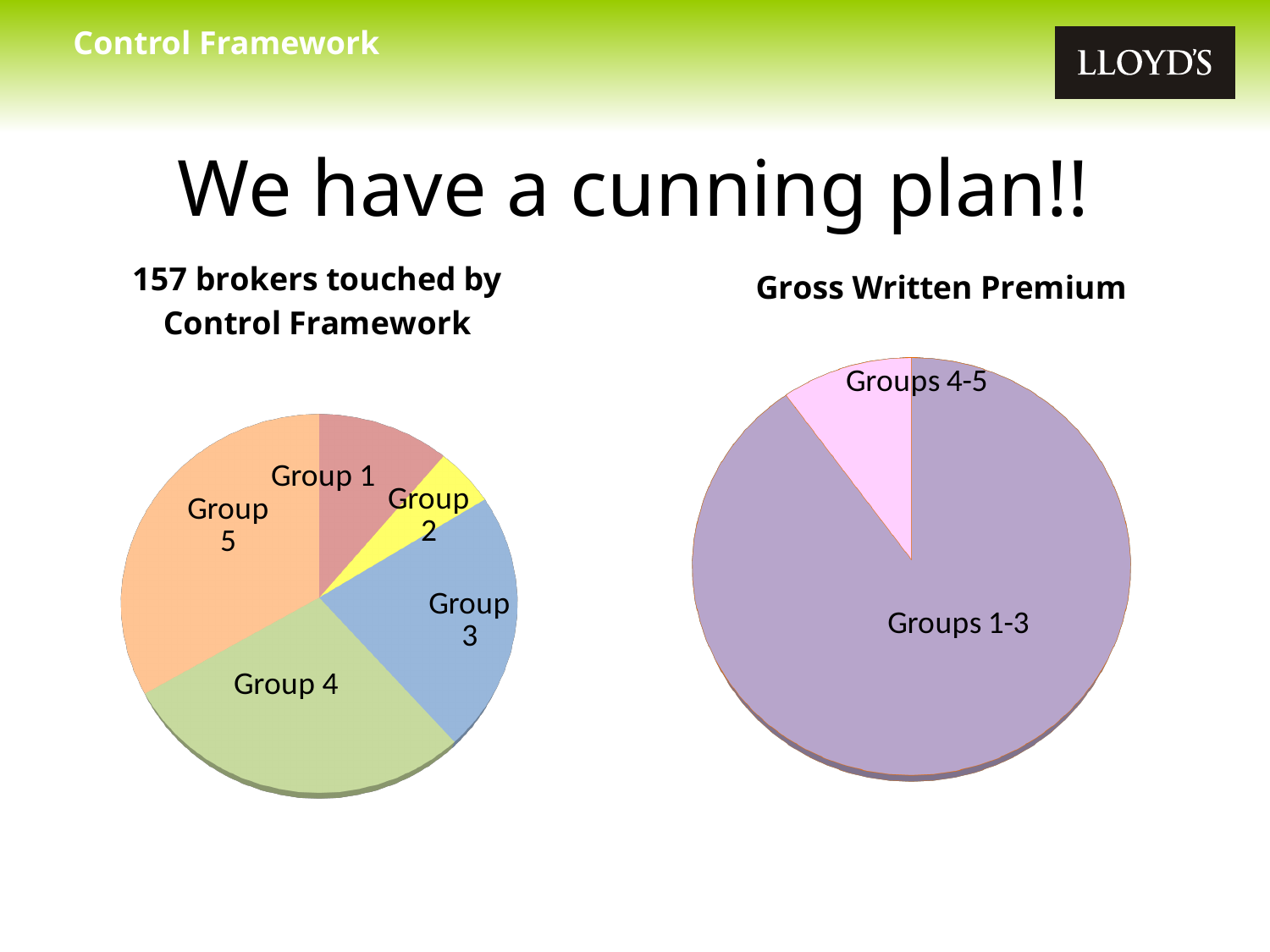
How many slices does the '157 brokers touched by Control Framework' pie chart have? 5 In the '157 brokers touched by Control Framework' chart, what colour is the Group 4 slice? green How many slices does the 'Gross Written Premium' pie chart have? 2 In the 'Gross Written Premium' chart, which slice is the largest? Groups 1-3 What kind of chart is the '157 brokers touched by Control Framework' chart? pie chart In the '157 brokers touched by Control Framework' chart, which group has the smallest slice? Group 2 What is the title of the pie chart on the right of the slide? Gross Written Premium What kind of chart is the 'Gross Written Premium' chart? pie chart In the '157 brokers touched by Control Framework' chart, which slice is larger, Group 2 or Group 3? Group 3 In the 'Gross Written Premium' chart, which slice is the smallest? Groups 4-5 In the 'Gross Written Premium' chart, which slice is larger, Groups 1-3 or Groups 4-5? Groups 1-3 In the '157 brokers touched by Control Framework' chart, which slice is larger, Group 1 or Group 2? Group 1